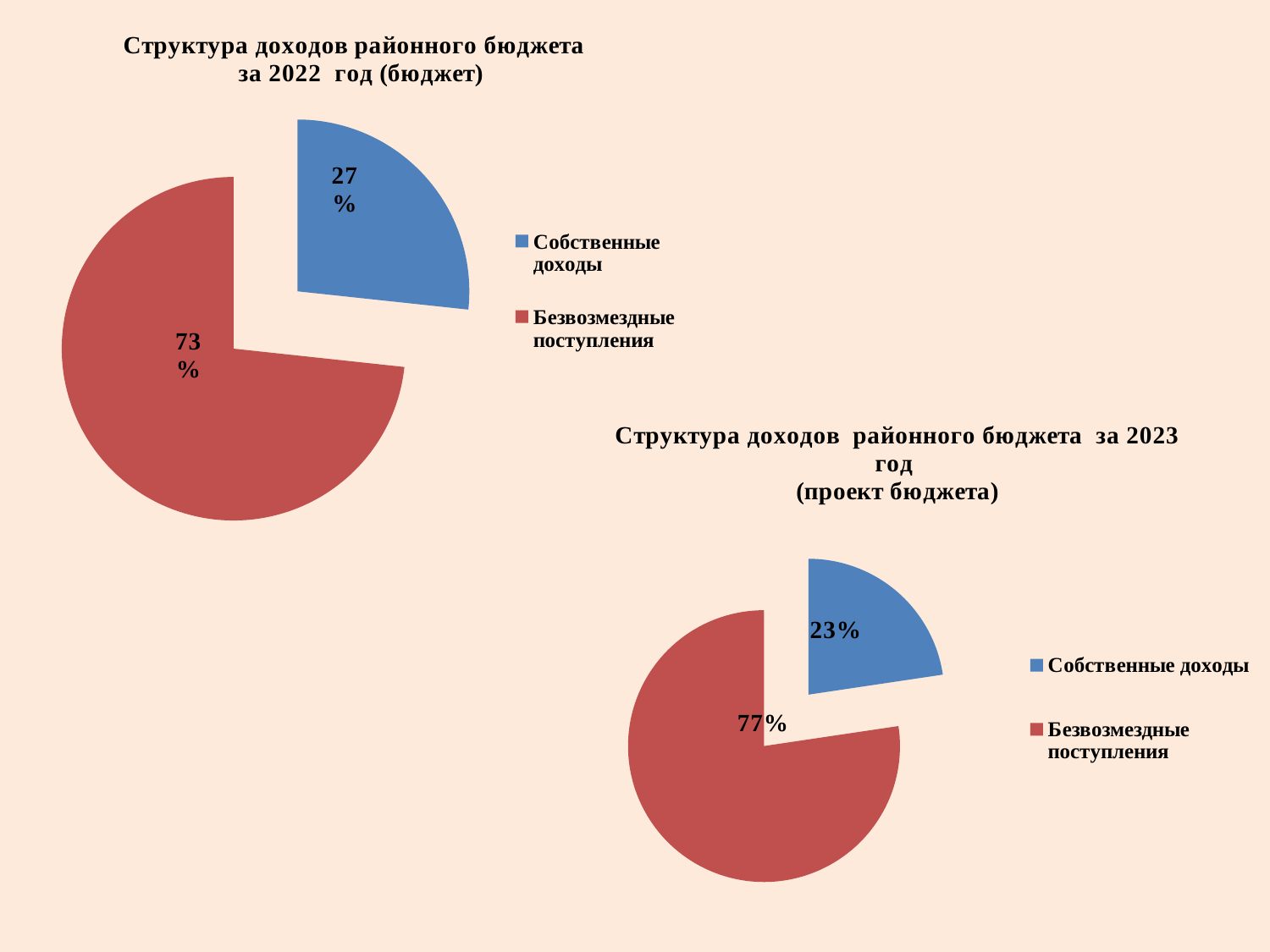
In the 2022 chart (top left), what is the difference in percentage points between Безвозмездные поступления and Собственные доходы? 46 In the 2023 chart (bottom right), what is the difference in percentage points between Безвозмездные поступления and Собственные доходы? 54 In the 2022 chart (top left), what share of revenue is Собственные доходы? 27% How many categories does the 2023 chart (bottom right) show? 2 In the 2023 chart (bottom right), what share of revenue is Собственные доходы? 23% In the 2023 chart (bottom right), which category has the smallest slice? Собственные доходы In the 2022 chart (top left), what share of revenue is Безвозмездные поступления? 73% What type of chart is used for the 2022 revenue structure (top left)? Pie chart In the 2022 chart (top left), which category has the largest slice? Безвозмездные поступления In the 2022 chart (top left), what colour is the Собственные доходы slice? Blue Is the share of Собственные доходы larger in the 2022 chart or the 2023 chart? 2022 In the 2023 chart (bottom right), what share of revenue is Безвозмездные поступления? 77%